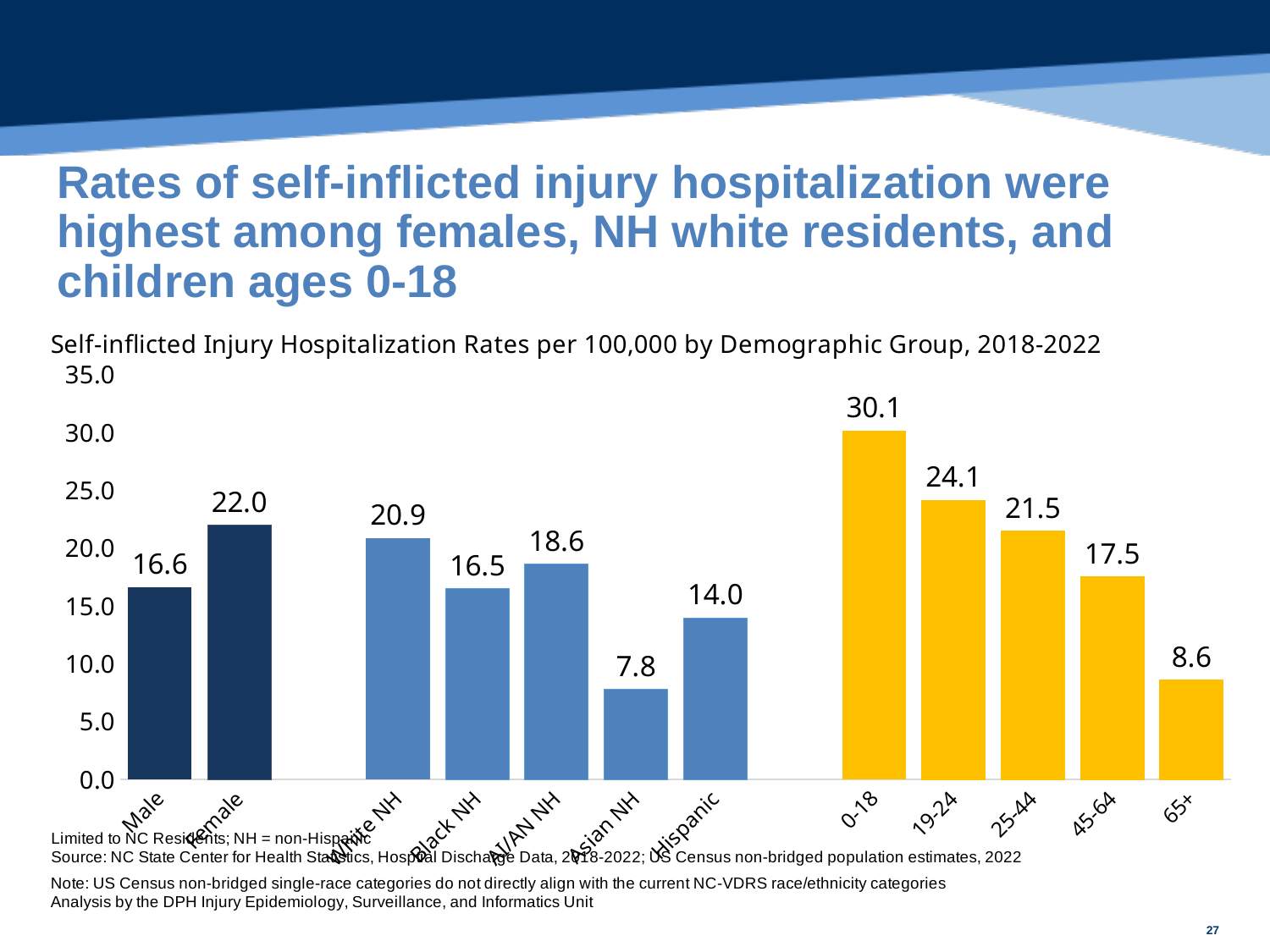
Which demographic group has the highest hospitalization rate? 0-18 What is the hospitalization rate for Asian NH residents? 7.8 Which demographic group has the lowest hospitalization rate? Asian NH Which has a higher hospitalization rate, White NH or Hispanic residents? White NH What is the difference between the female and male hospitalization rates? 5.4 Do the hospitalization rates rise or fall across the age groups from 0-18 to 65+? Fall What is the self-inflicted injury hospitalization rate per 100,000 for females? 22.0 What is the difference between the rates for the 0-18 and 65+ age groups? 21.5 Is the hospitalization rate for the 19-24 age group greater or less than 20.0? greater What is the hospitalization rate for the 0-18 age group? 30.1 How many demographic groups are shown on the chart? 12 What kind of chart is shown on the slide? Bar chart